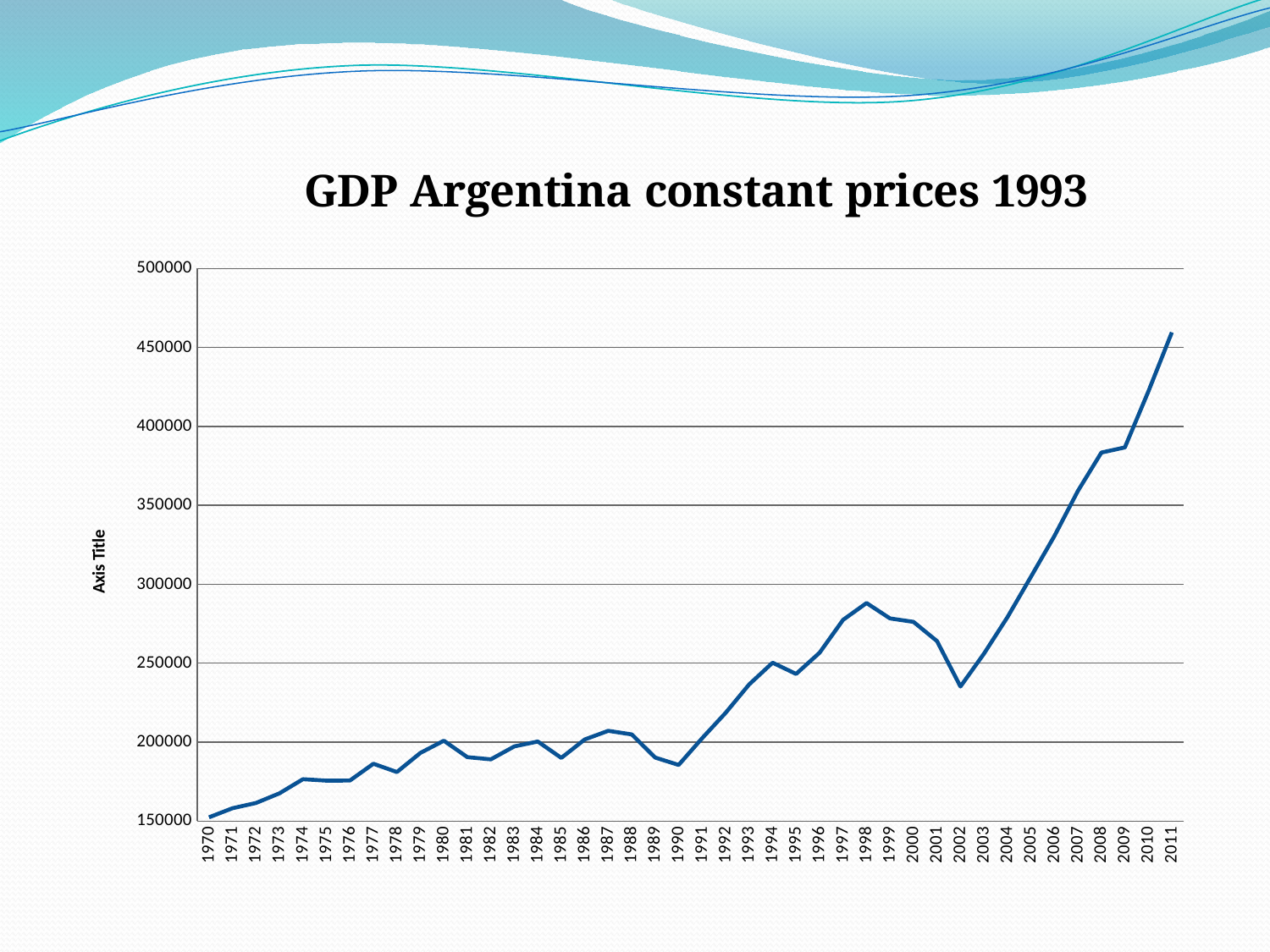
Is the value for 2002 greater or less than 250000? less What is the title of the chart? GDP Argentina constant prices 1993 What kind of chart is shown on the slide? line chart Overall, does the GDP value rise or fall from 1970 to 2011? rise Which year has the larger value, 1998 or 2002? 1998 Which year has the lowest GDP value in the chart? 1970 Which year has the highest GDP value in the chart? 2011 Is the value for 1998 greater or less than 300000? less Is the value for 1990 greater or less than 200000? less How many years are plotted along the x axis of the chart? 42